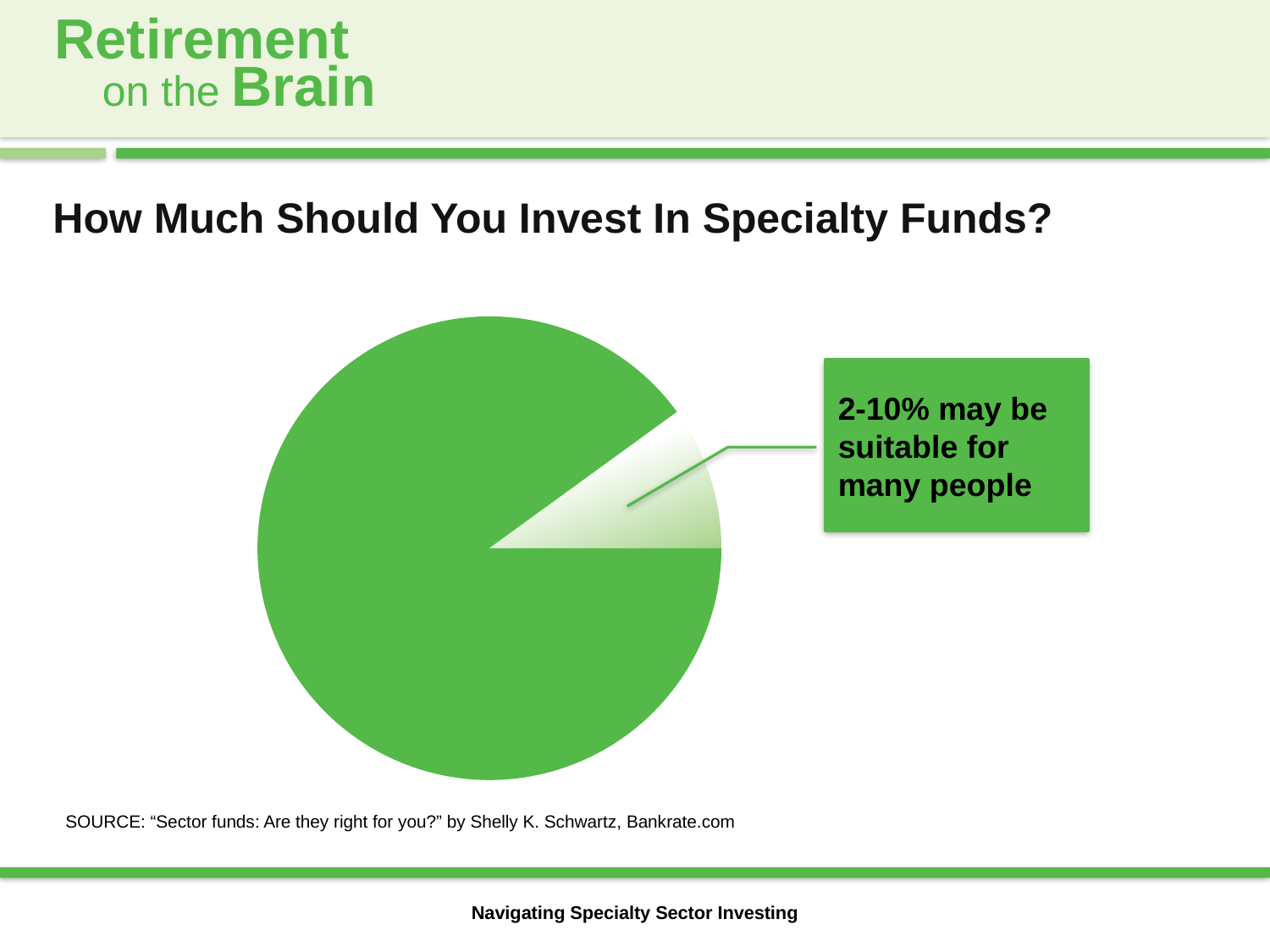
Which slice of the pie chart is larger, the dark green slice or the light slice with the callout? The dark green slice What kind of chart is shown on the slide? Pie chart Which slice of the pie chart is the smallest? The light slice with the callout Does the small slice of the pie chart represent more or less than half of the pie? less What does the callout attached to the small slice of the pie chart say? 2-10% may be suitable for many people What range of investment does the callout on the pie chart say may be suitable for many people? 2-10%